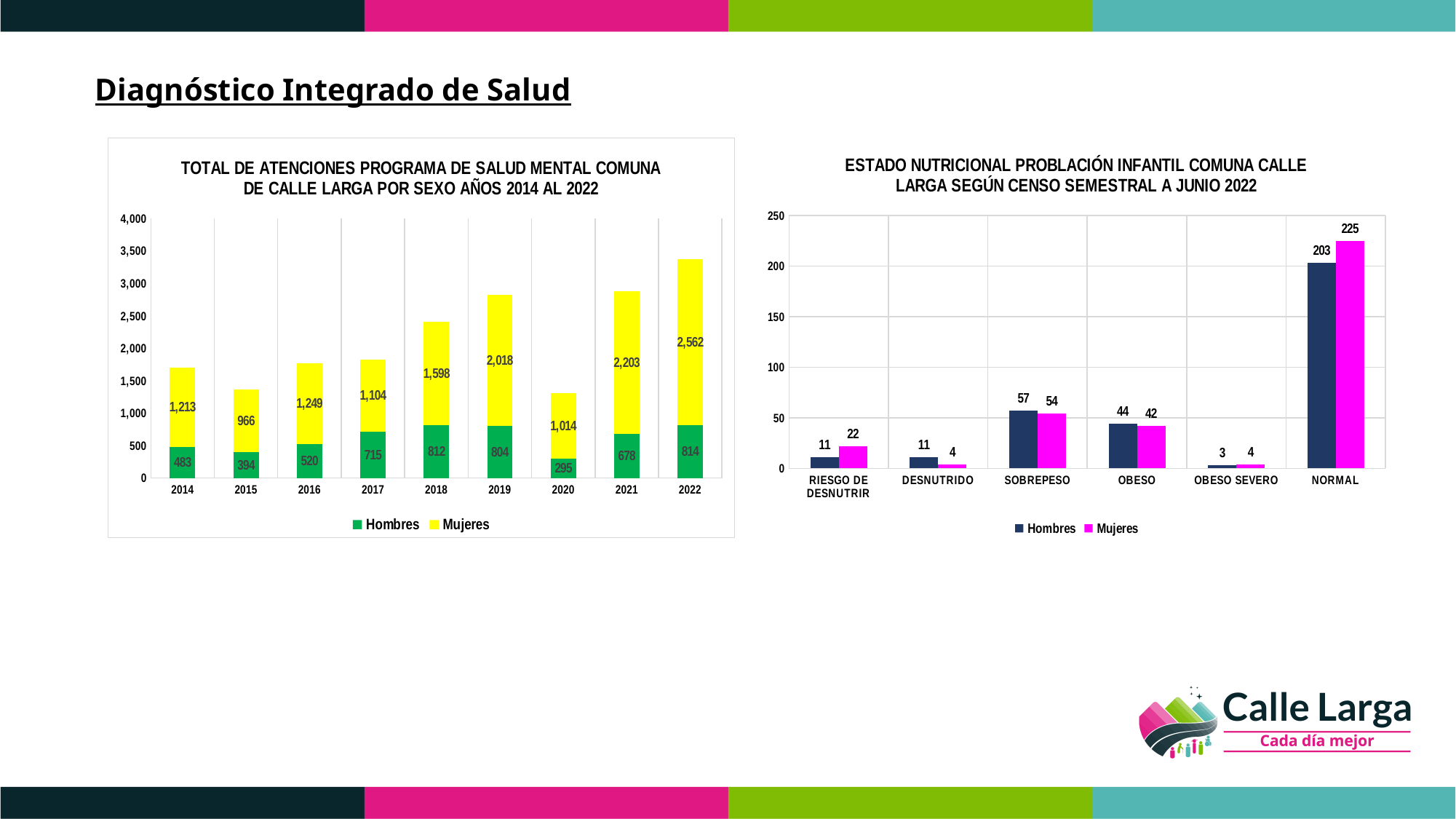
In the left chart (Total de Atenciones Programa de Salud Mental), how many years are shown on the x axis? 9 In the right chart (Estado Nutricional Problación Infantil), what is the Mujeres value for NORMAL? 225 In the right chart (Estado Nutricional Problación Infantil), which category has the lowest Hombres value? OBESO SEVERO What type of chart is the right chart (Estado Nutricional Problación Infantil)? Bar chart In the left chart (Total de Atenciones Programa de Salud Mental), what is the total of the stacked bar for 2022? 3,376 In the left chart (Total de Atenciones Programa de Salud Mental), what is the difference between the Mujeres and Hombres values in 2021? 1,525 In the left chart (Total de Atenciones Programa de Salud Mental), which year has the lowest Hombres value? 2020 In the left chart (Total de Atenciones Programa de Salud Mental), which year has the highest Mujeres value? 2022 In the left chart (Total de Atenciones Programa de Salud Mental), what is the Mujeres value for 2019? 2,018 In the right chart (Estado Nutricional Problación Infantil), which is larger for DESNUTRIDO, Hombres or Mujeres? Hombres In the left chart (Total de Atenciones Programa de Salud Mental), what is the Hombres value for 2020? 295 In the right chart (Estado Nutricional Problación Infantil), what is the difference between the Hombres and Mujeres values for RIESGO DE DESNUTRIR? 11